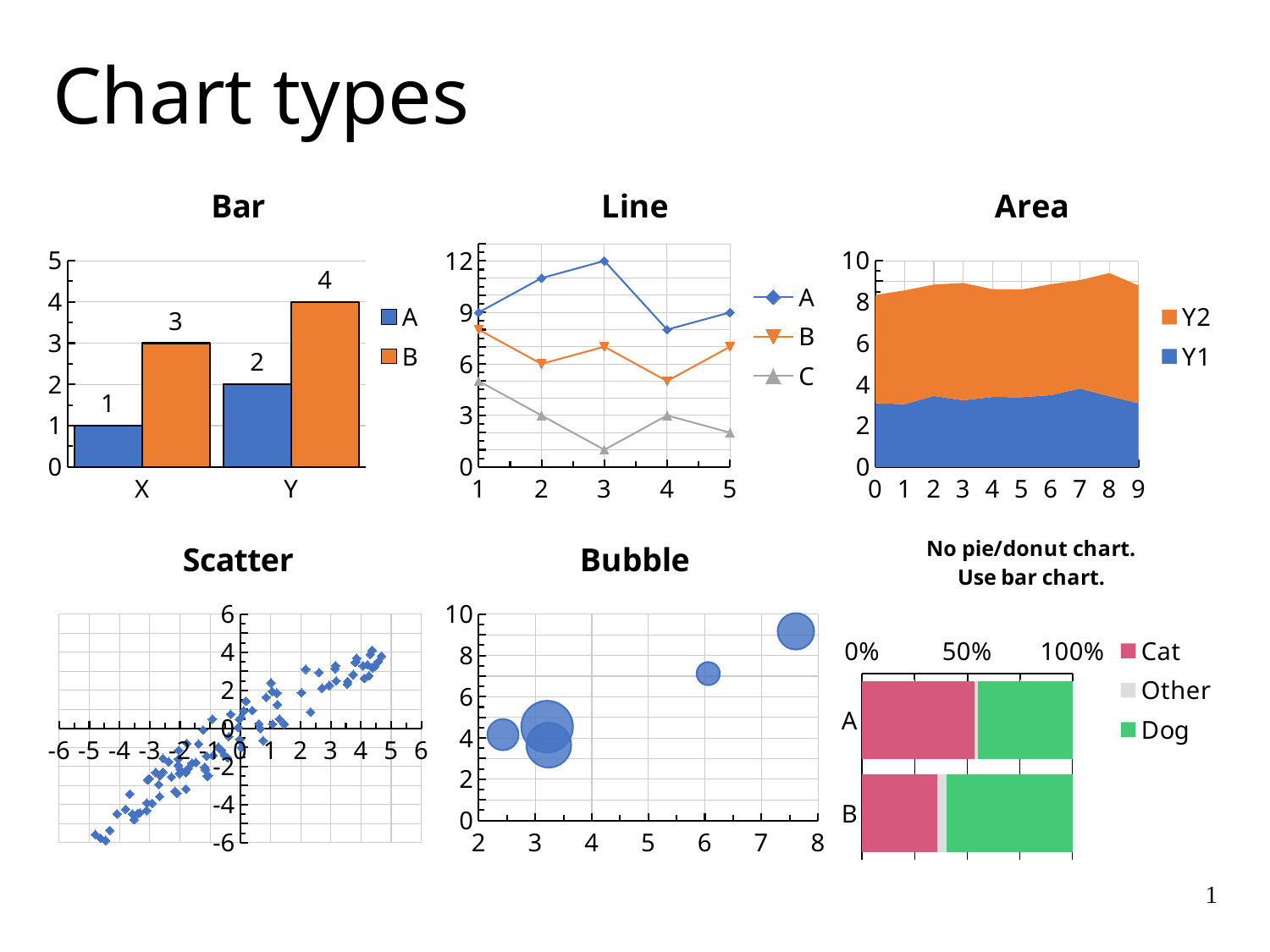
In the Bar chart, what is the value of series B for category Y? 4 What kind of chart is the bottom-right chart titled 'No pie/donut chart. Use bar chart.'? bar chart How many series does the legend of the Area chart list? 2 In the Line chart, is the value of series B at x = 4 greater or less than 6? less In the bottom-right chart (No pie/donut chart. Use bar chart.), is the Cat share for category B greater or less than 50%? less In the Bar chart, what is the difference between series B and series A for category X? 2 In the Line chart, at which x value does series A reach its highest point? 3 In the Bar chart, what is the value of series A for category X? 1 In the Bar chart, which category has the higher value for series A, X or Y? Y In the Scatter chart, do the points generally rise or fall as x increases? rise How many series does the legend of the Line chart list? 3 In the Line chart, at which x value does series C reach its lowest point? 3